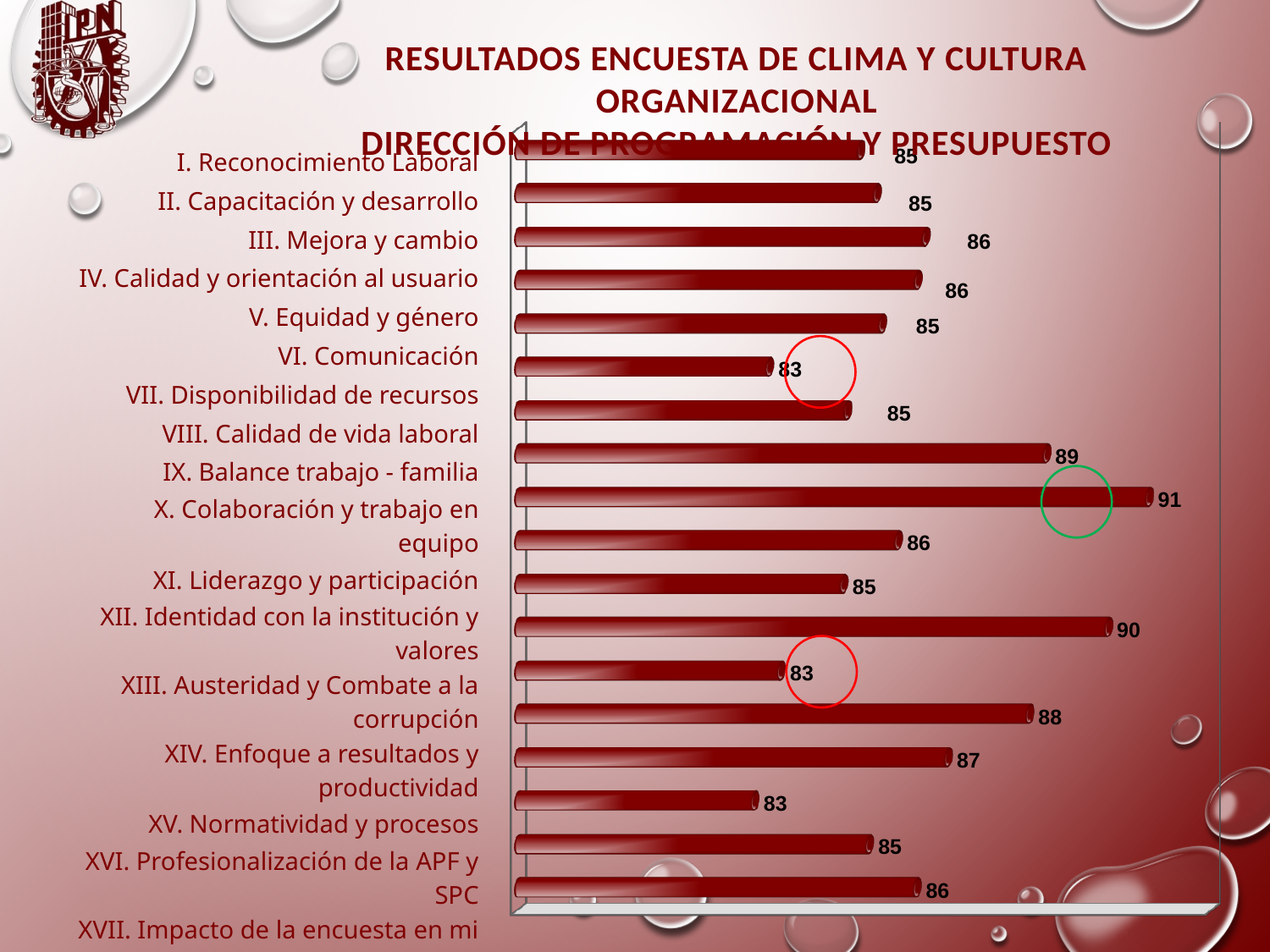
How many bars in the chart have the value 85? 6 What is the difference between the highest value (91) and the lowest value (83) in the chart? 8 How many bars are plotted in the chart? 18 What is the value of the third bar, for 'III. Mejora y cambio'? 86 What value is marked with the green circle in the chart? 91 What value do the bars marked with red circles have? 83 What is the value of the first bar, for 'I. Reconocimiento Laboral'? 85 What kind of chart is shown on the slide? bar chart Which is larger, the value of the longest bar (91) or the value of the bar labelled 90? 91 What is the highest value shown in the chart? 91 What is the lowest value shown in the chart? 83 How many bars in the chart have the value 83? 3